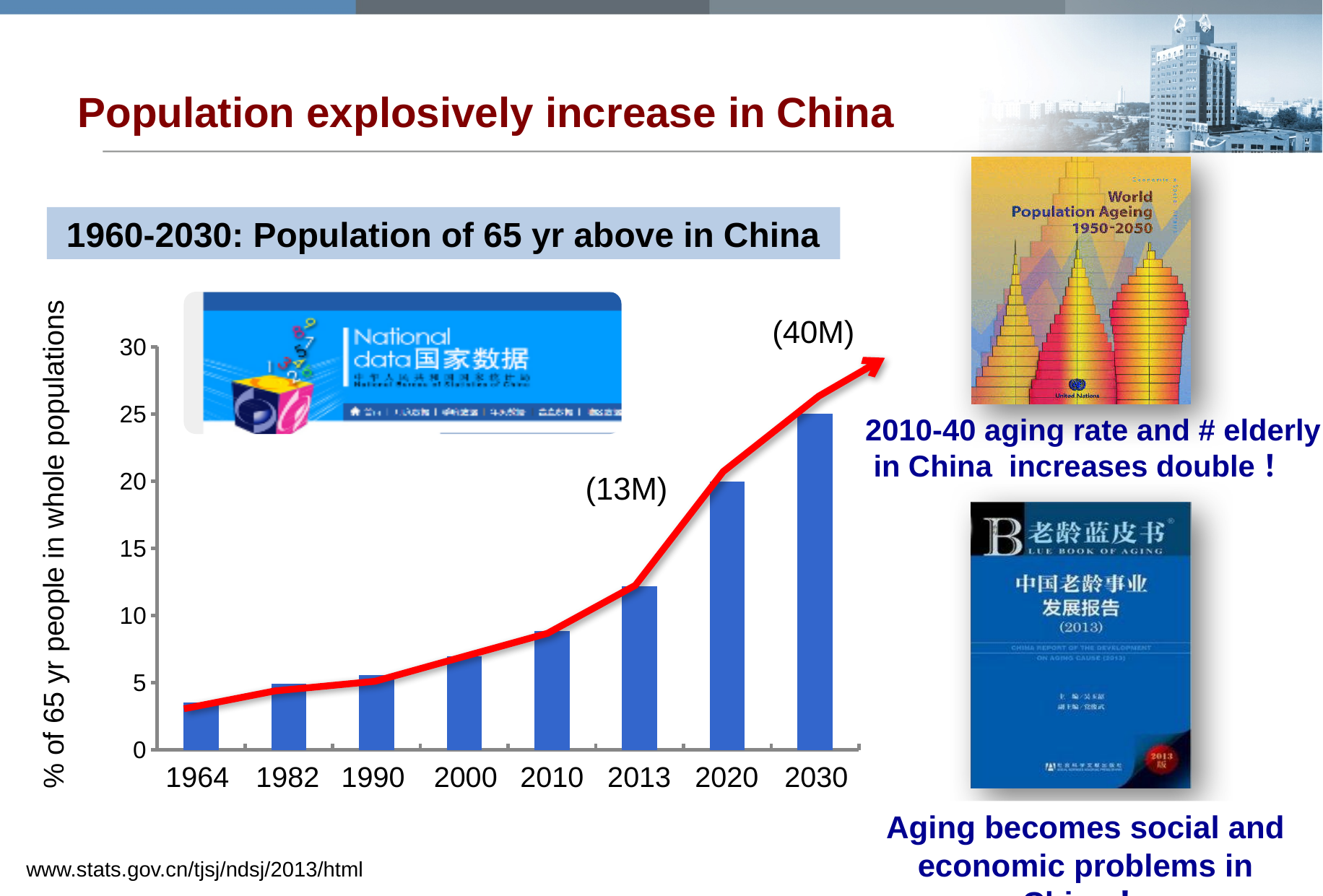
Which year has the lowest bar in the chart? 1964 What kind of chart is used to show the population of 65 yr above in China? bar chart Is the value for 2000 greater or less than 10? less Do the values rise or fall from 1964 to 2030? rise Is the value for 2013 greater or less than 10? greater Which year has the highest bar in the chart? 2030 Which year has a larger value, 2010 or 2020? 2020 What annotation is written above the 2030 bar? (40M) What is the value for 2030 in the chart? 25 What is the label of the y axis of the chart? % of 65 yr people in whole populations Is the value for 1964 greater or less than 5? less How many years are shown on the x axis of the chart? 8